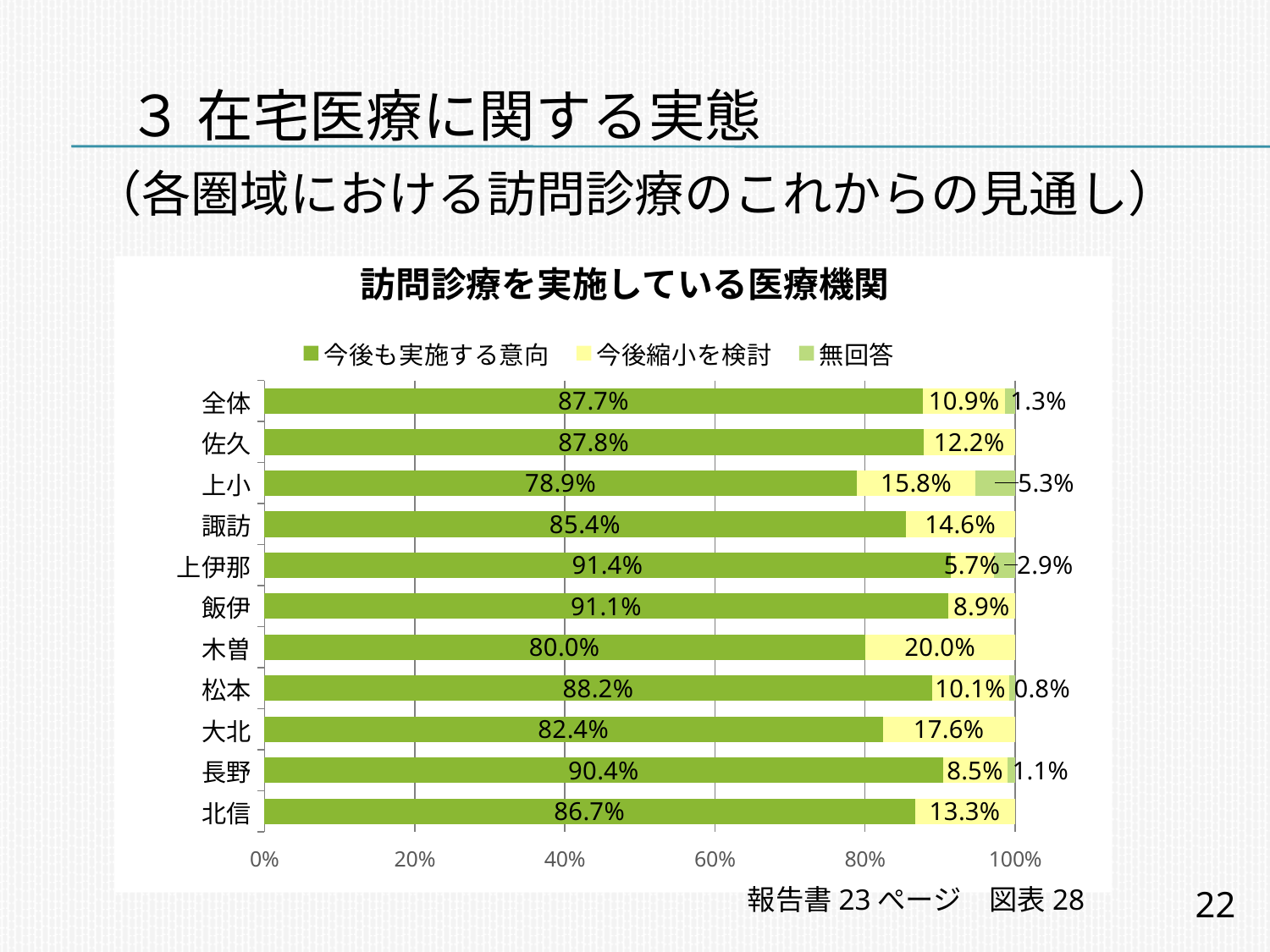
What is the value of 今後縮小を検討 for 木曽? 20.0% How many series does the legend list? 3 Which region has the highest value for 今後縮小を検討? 木曽 Which is larger, the 今後も実施する意向 value for 大北 or for 諏訪? 諏訪 What is the value of 無回答 for 上小? 5.3% Which region has the lowest value for 今後も実施する意向? 上小 How many regions (categories) are shown on the chart? 11 What kind of chart is shown on the slide? Stacked bar chart Which region has the highest value for 今後も実施する意向? 上伊那 What is the value of 今後も実施する意向 for 全体? 87.7% What is the difference between the 今後縮小を検討 values for 木曽 and 上小? 4.2 percentage points What is the title of the chart? 訪問診療を実施している医療機関